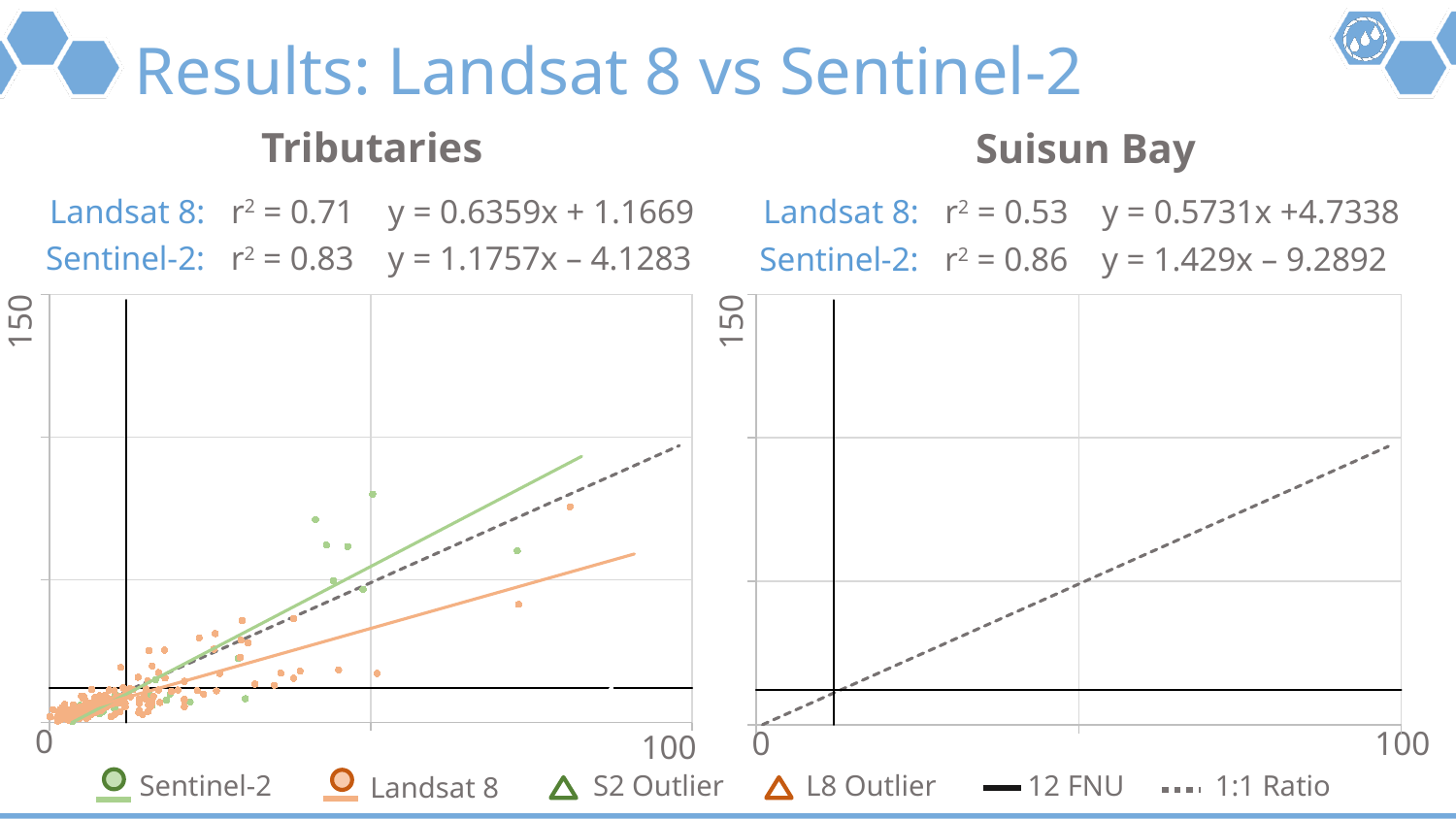
In the Tributaries chart, what is the r² value for Sentinel-2? 0.83 In the Tributaries chart, which sensor has the higher r², Landsat 8 or Sentinel-2? Sentinel-2 In the Tributaries chart, what is the regression equation shown for Sentinel-2? y = 1.1757x – 4.1283 How many entries does the legend at the bottom of the slide list? 6 What colour are the Sentinel-2 points and regression line in the Tributaries chart? green In the Tributaries chart, what is the difference between the Sentinel-2 r² and the Landsat 8 r²? 0.12 What kind of chart is the Tributaries chart? scatter chart In the Suisun Bay chart, what is the r² value for Sentinel-2? 0.86 In the Suisun Bay chart, what is the difference between the Sentinel-2 r² and the Landsat 8 r²? 0.33 In the Suisun Bay chart, what is the r² value for Landsat 8? 0.53 In the Tributaries chart, do the plotted points generally rise or fall as the x-axis value increases? rise In the Tributaries chart, what is the r² value for Landsat 8? 0.71